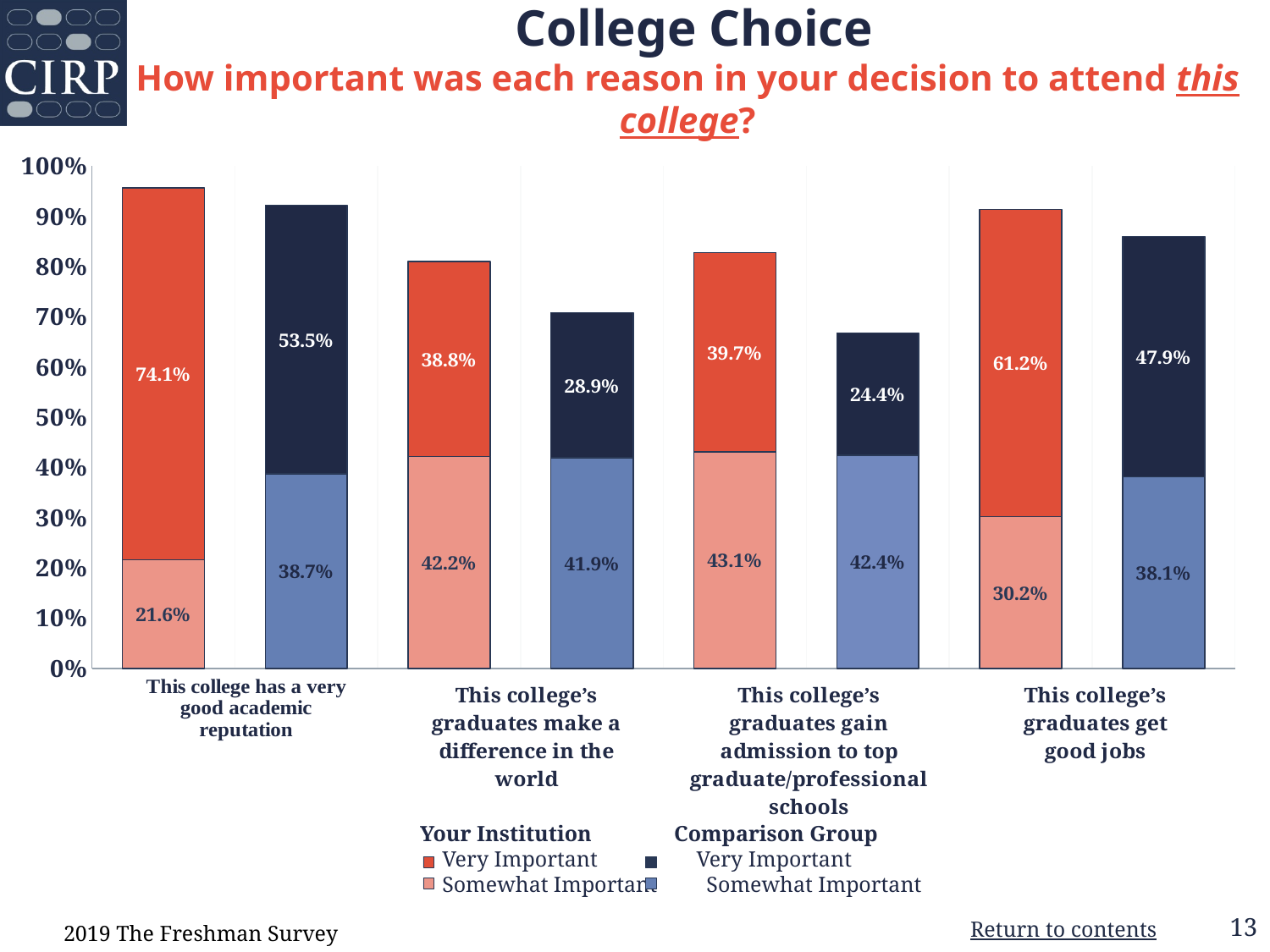
What is the total stacked bar value (Very Important plus Somewhat Important) for the Comparison Group on 'This college's graduates gain admission to top graduate/professional schools'? 66.8% What kind of chart is shown on the slide? Stacked bar chart What percentage of Your Institution students rated 'This college has a very good academic reputation' as Very Important? 74.1% How many series does the legend list? 4 Which reason has the lowest Very Important percentage for the Comparison Group? This college's graduates gain admission to top graduate/professional schools What percentage of Your Institution students rated 'This college's graduates gain admission to top graduate/professional schools' as Somewhat Important? 43.1% For 'This college's graduates make a difference in the world', which is larger: the Your Institution Very Important percentage or the Comparison Group Very Important percentage? Your Institution Which reason has the highest Very Important percentage for Your Institution? This college has a very good academic reputation What percentage of the Comparison Group rated 'This college's graduates get good jobs' as Somewhat Important? 38.1% How many reasons (categories) are shown on the x axis of the chart? 4 What is the difference between the Your Institution and Comparison Group Very Important percentages for 'This college's graduates get good jobs'? 13.3% What is the total stacked bar value (Very Important plus Somewhat Important) for Your Institution on 'This college has a very good academic reputation'? 95.7%